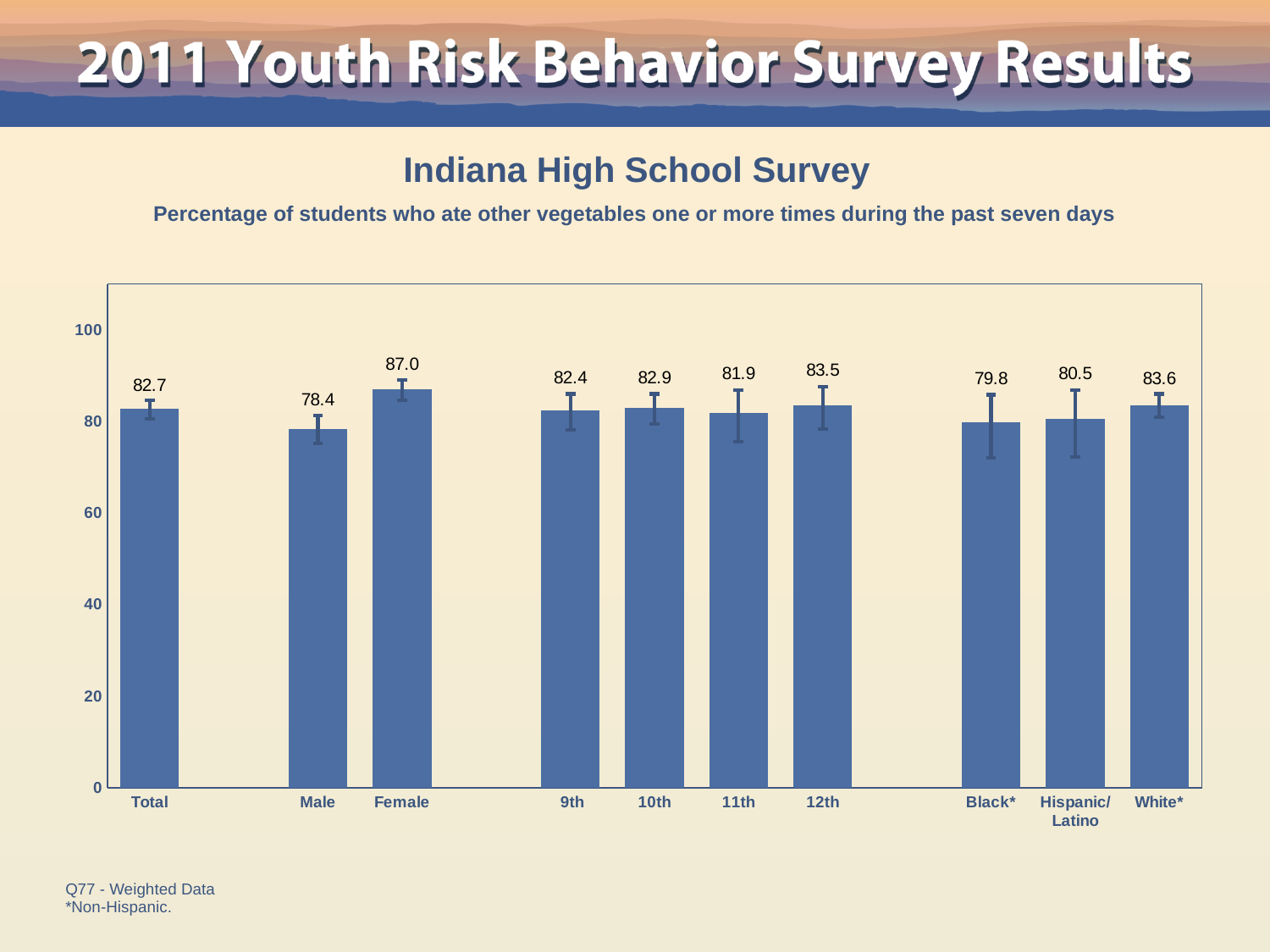
Is the value for Male greater or less than 80? less What is the subtitle describing what the chart measures? Percentage of students who ate other vegetables one or more times during the past seven days What is the value for Hispanic/Latino? 80.5 What is the difference between the Female and Male values? 8.6 How many categories are shown on the x axis? 10 What is the value for Female? 87.0 Which is larger, the value for Black* or the value for White*? White* What is the value for Total? 82.7 What is the value for 11th? 81.9 Which category has the highest value? Female What kind of chart is shown? bar chart Which category has the lowest value? Male